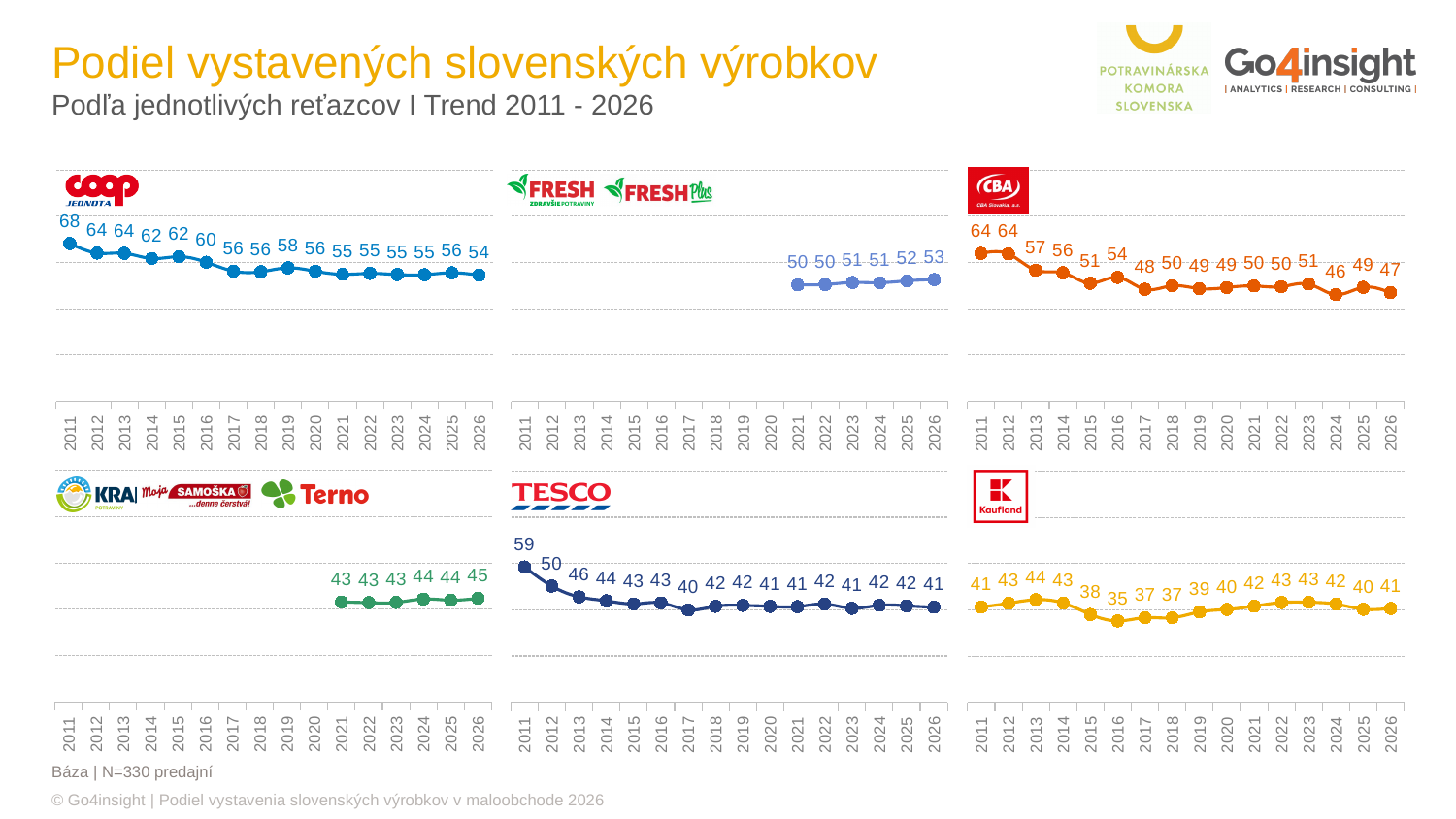
In the CBA chart, what is the difference between the 2011 value and the 2026 value? 17 In the Tesco chart, what is the value for 2011? 59 In the Kraj/Samoška/Terno chart, do the values rise or fall from 2021 to 2026? rise In the Kaufland chart, which year has the lowest value? 2016 In the Kaufland chart, what is the value for 2016? 35 In the COOP Jednota chart, what is the value for 2026? 54 In the Fresh chart, what is the value for 2026? 53 In the Tesco chart, do the values generally rise or fall from 2011 to 2026? fall What type of chart is used for each retail chain on the slide? line chart In the Fresh chart, how many data points are plotted? 6 Which is larger: the 2026 value in the COOP Jednota chart or the 2026 value in the Tesco chart? COOP Jednota In the COOP Jednota chart, what is the value for 2011? 68